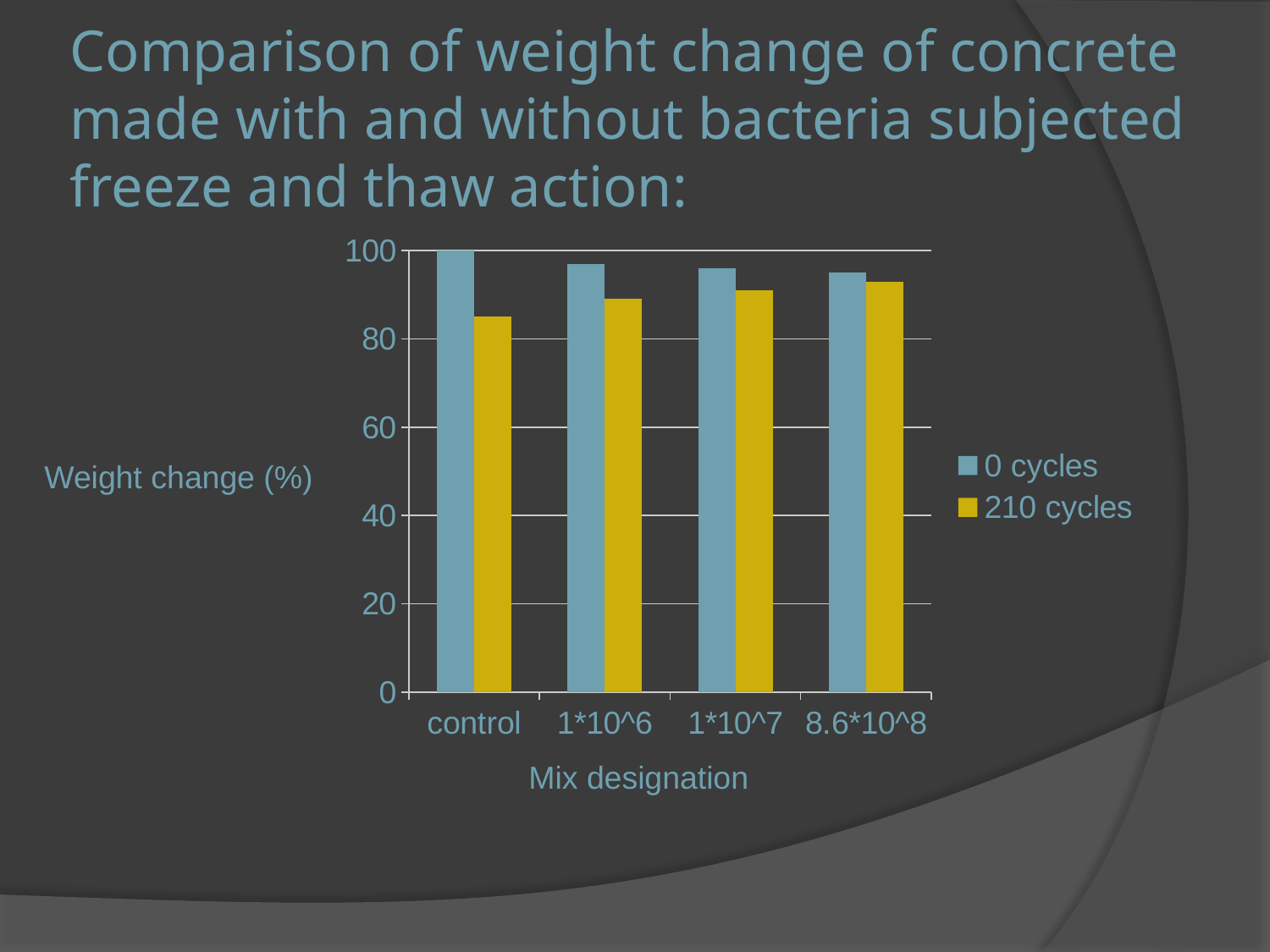
What is the weight change value for the control mix at 0 cycles? 100 Which mix designation has the highest value for 0 cycles? control How many series does the legend list? 2 What kind of chart is shown on the slide? bar chart For the control mix, which is larger: the 0 cycles value or the 210 cycles value? 0 cycles Which series is shown in yellow? 210 cycles Is the value for the control mix at 210 cycles greater or less than 80? greater What is the label of the x axis? Mix designation How many mix designations are shown on the x axis? 4 Which mix designation has the lowest value for 210 cycles? control Do the 210 cycles values rise or fall moving from control to 8.6*10^8 along the x axis? rise Is the value for the 1*10^6 mix at 210 cycles greater or less than 80? greater